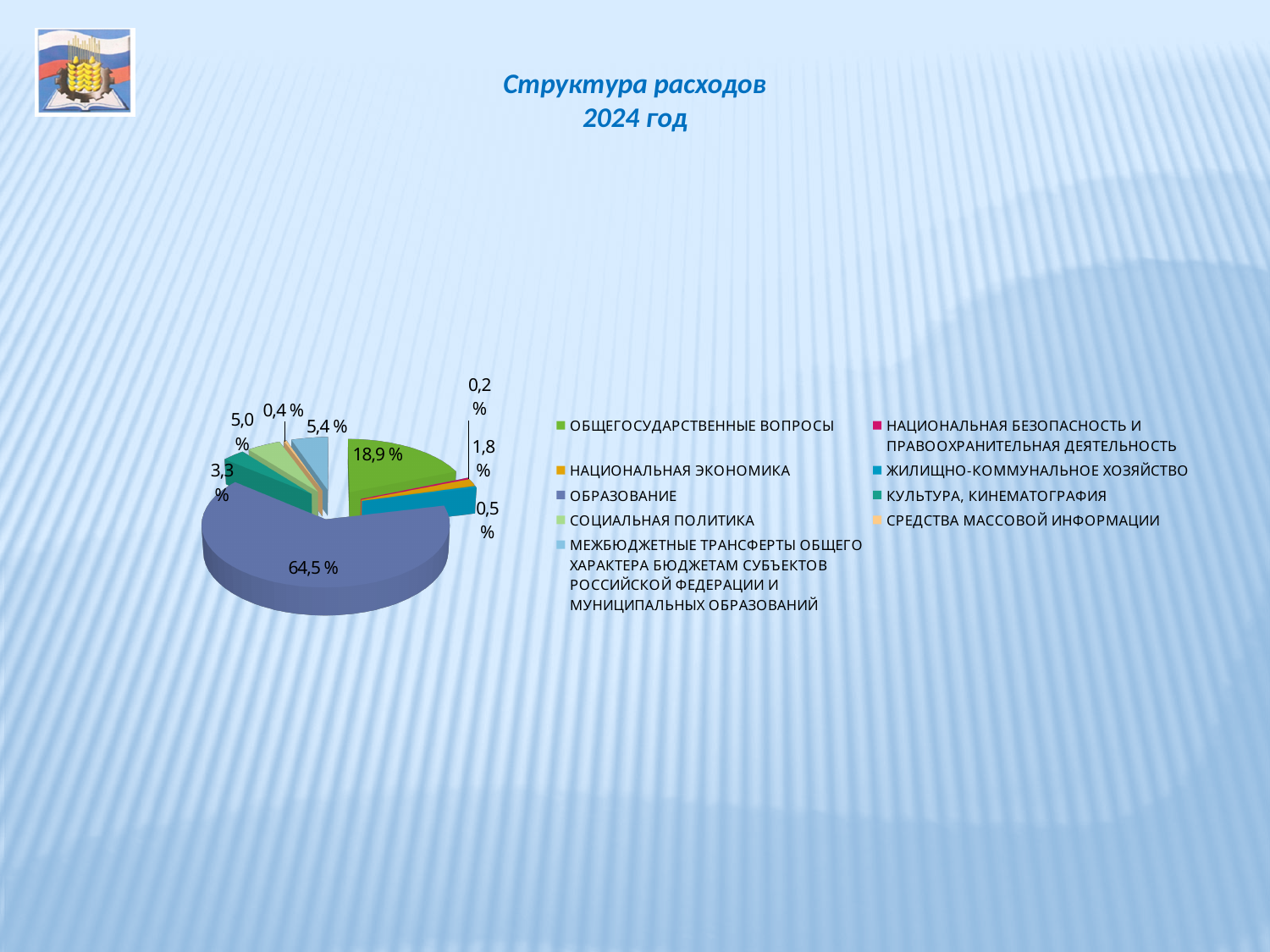
What share of expenditures goes to ОБЩЕГОСУДАРСТВЕННЫЕ ВОПРОСЫ? 18,9 % What share of expenditures goes to ОБРАЗОВАНИЕ? 64,5 % Which category has the largest share of the pie? ОБРАЗОВАНИЕ How many categories does the legend list? 9 What kind of chart is shown on the slide? pie chart Which has the larger share, СОЦИАЛЬНАЯ ПОЛИТИКА or КУЛЬТУРА, КИНЕМАТОГРАФИЯ? СОЦИАЛЬНАЯ ПОЛИТИКА What share is shown for МЕЖБЮДЖЕТНЫЕ ТРАНСФЕРТЫ ОБЩЕГО ХАРАКТЕРА? 5,4 % Which category has the smallest share of the pie? НАЦИОНАЛЬНАЯ БЕЗОПАСНОСТЬ И ПРАВООХРАНИТЕЛЬНАЯ ДЕЯТЕЛЬНОСТЬ What is the title of the chart? Структура расходов 2024 год By how many percentage points does the share of ОБРАЗОВАНИЕ exceed that of ОБЩЕГОСУДАРСТВЕННЫЕ ВОПРОСЫ? 45,6 %